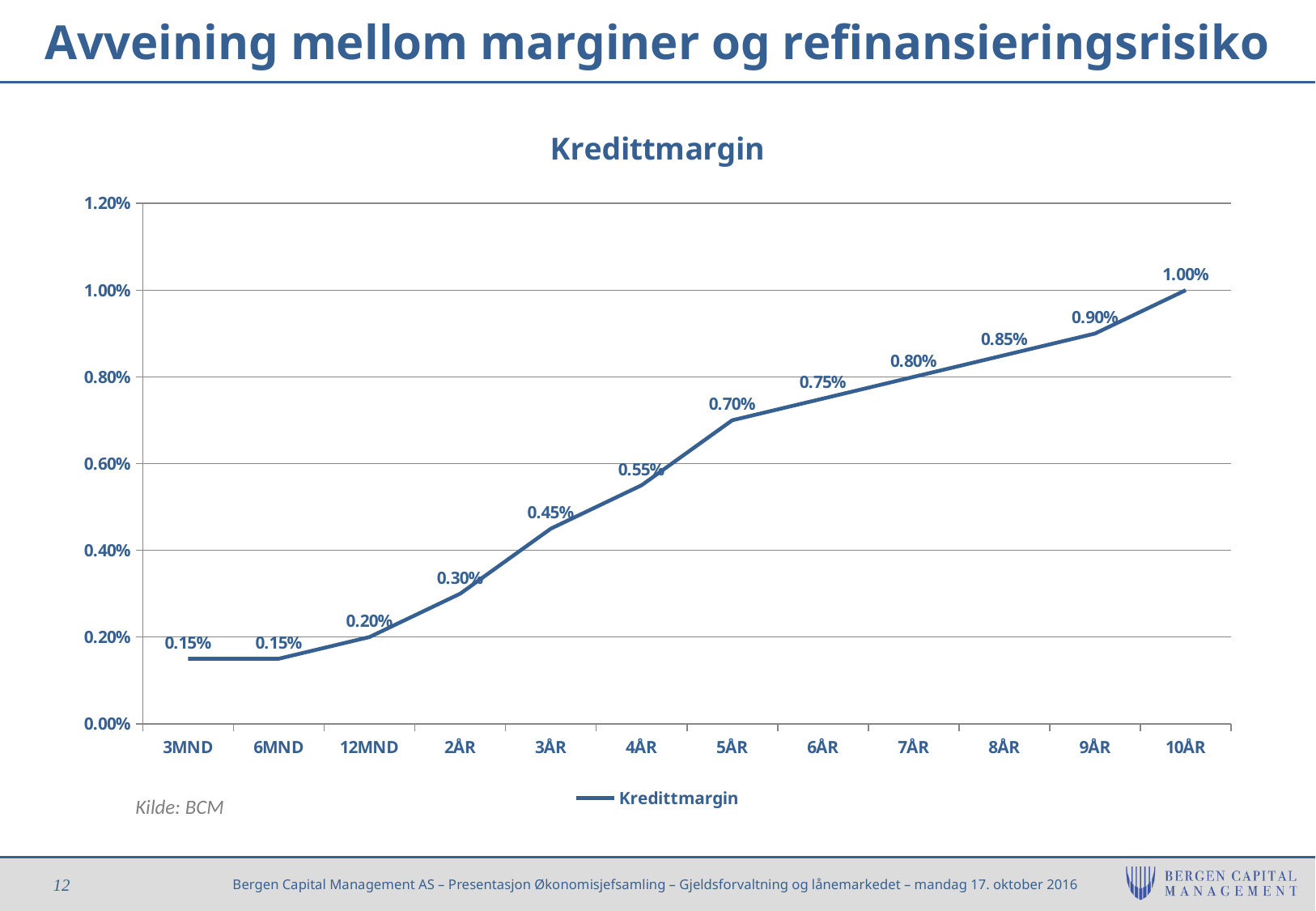
What is the difference between the Kredittmargin values for 5ÅR and 4ÅR? 0.15% How many categories are shown on the x axis of the chart? 12 What is the Kredittmargin value for 8ÅR? 0.85% How many series does the legend list? 1 Which has a larger Kredittmargin value, 3ÅR or 7ÅR? 7ÅR Is the Kredittmargin value for 6ÅR greater or less than 0.60%? greater What is the Kredittmargin value for 5ÅR? 0.70% What is the difference between the Kredittmargin values for 10ÅR and 3MND? 0.85% What kind of chart is shown on the slide? Line chart Which category has the highest Kredittmargin value? 10ÅR Do the Kredittmargin values rise or fall from 3MND to 10ÅR? Rise What is the Kredittmargin value for 12MND? 0.20%